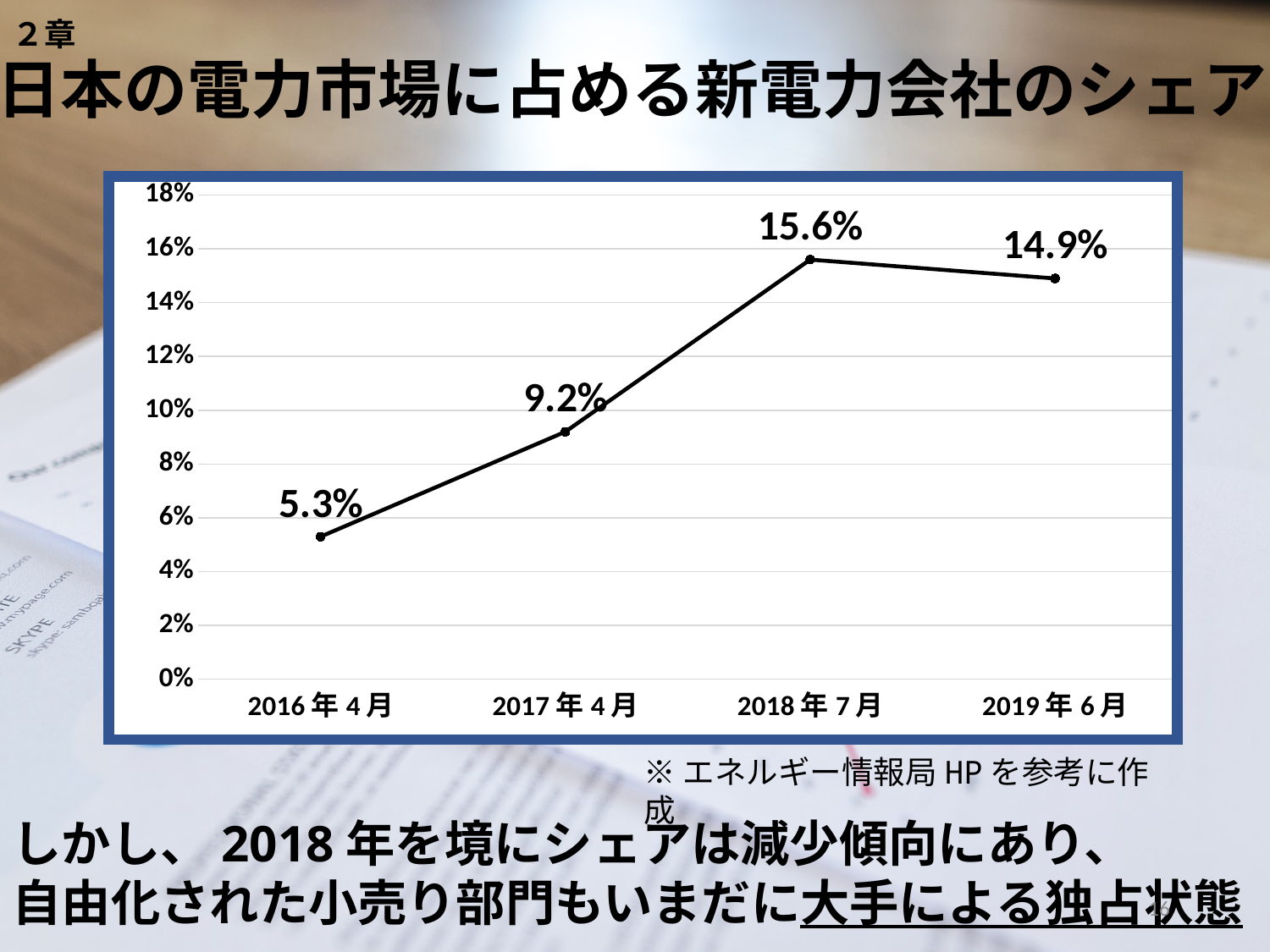
What is the share of new electric power companies in 2017年4月? 9.2% How many data points are plotted on the line chart? 4 Does the share rise or fall from 2016年4月 to 2018年7月? rise What kind of chart is shown on the slide? line chart What is the share of new electric power companies in 2019年6月? 14.9% What is the share of new electric power companies in 2018年7月? 15.6% Which time point has the highest share? 2018年7月 Which is larger, the share in 2017年4月 or the share in 2019年6月? 2019年6月 Which time point has the lowest share? 2016年4月 What is the difference between the share in 2018年7月 and the share in 2019年6月? 0.7% What is the share of new electric power companies in 2016年4月? 5.3% What is the difference between the share in 2017年4月 and the share in 2016年4月? 3.9%